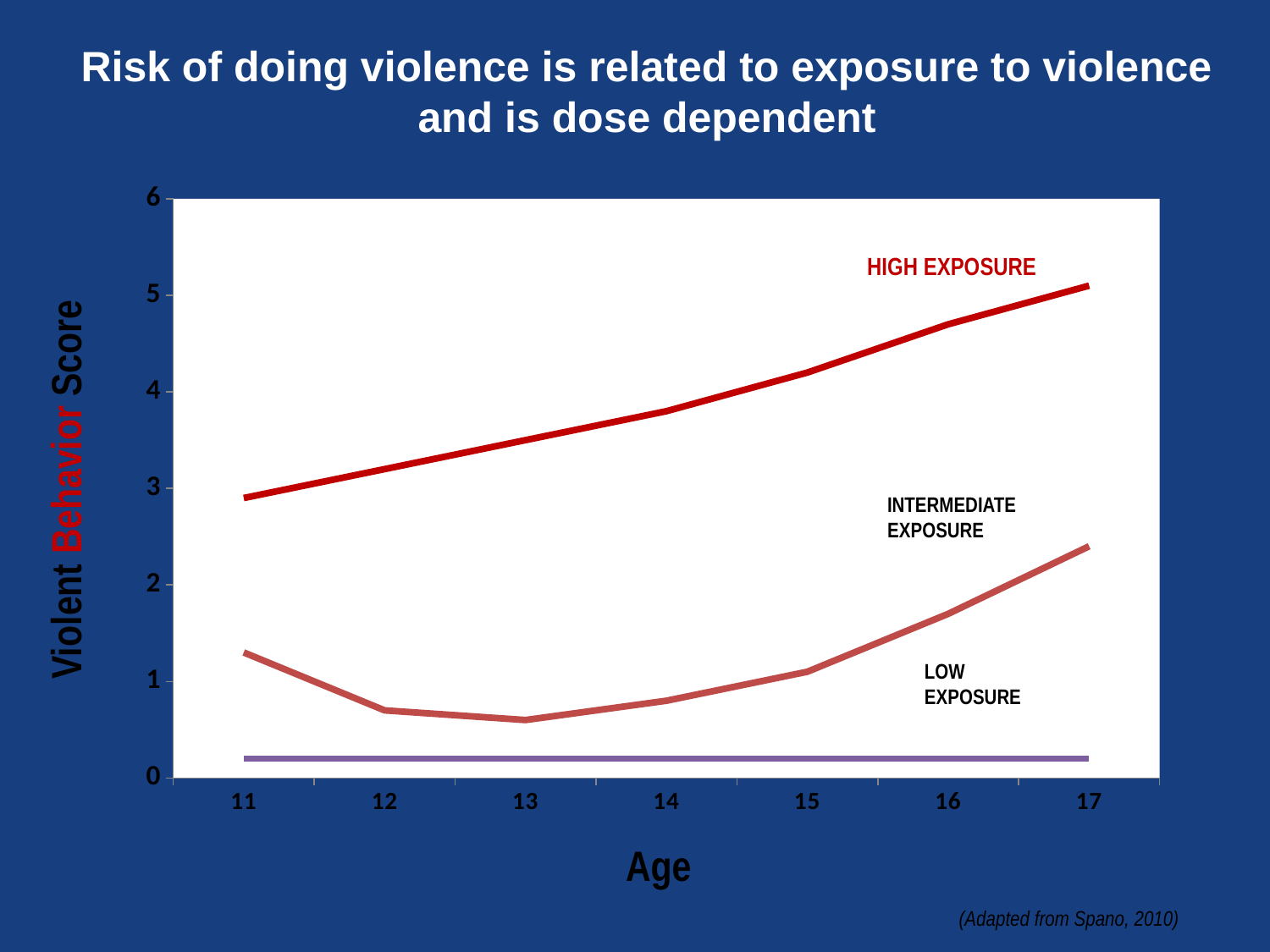
At age 14, which group has the higher Violent Behavior Score, High Exposure or Intermediate Exposure? High Exposure Is the Violent Behavior Score for the Low Exposure group at age 17 greater or less than 1? less Is the Violent Behavior Score for the Intermediate Exposure group at age 13 greater or less than 1? less How many age points are shown along the x axis? 7 How many exposure groups (lines) are plotted on the chart? 3 Does the Violent Behavior Score for the High Exposure group rise or fall as age increases from 11 to 17? Rise What kind of chart is shown on the slide? Line chart Is the Violent Behavior Score for the High Exposure group at age 17 greater or less than 4? greater What is the label of the y axis? Violent Behavior Score Which exposure group has the lowest Violent Behavior Score at age 17? Low Exposure